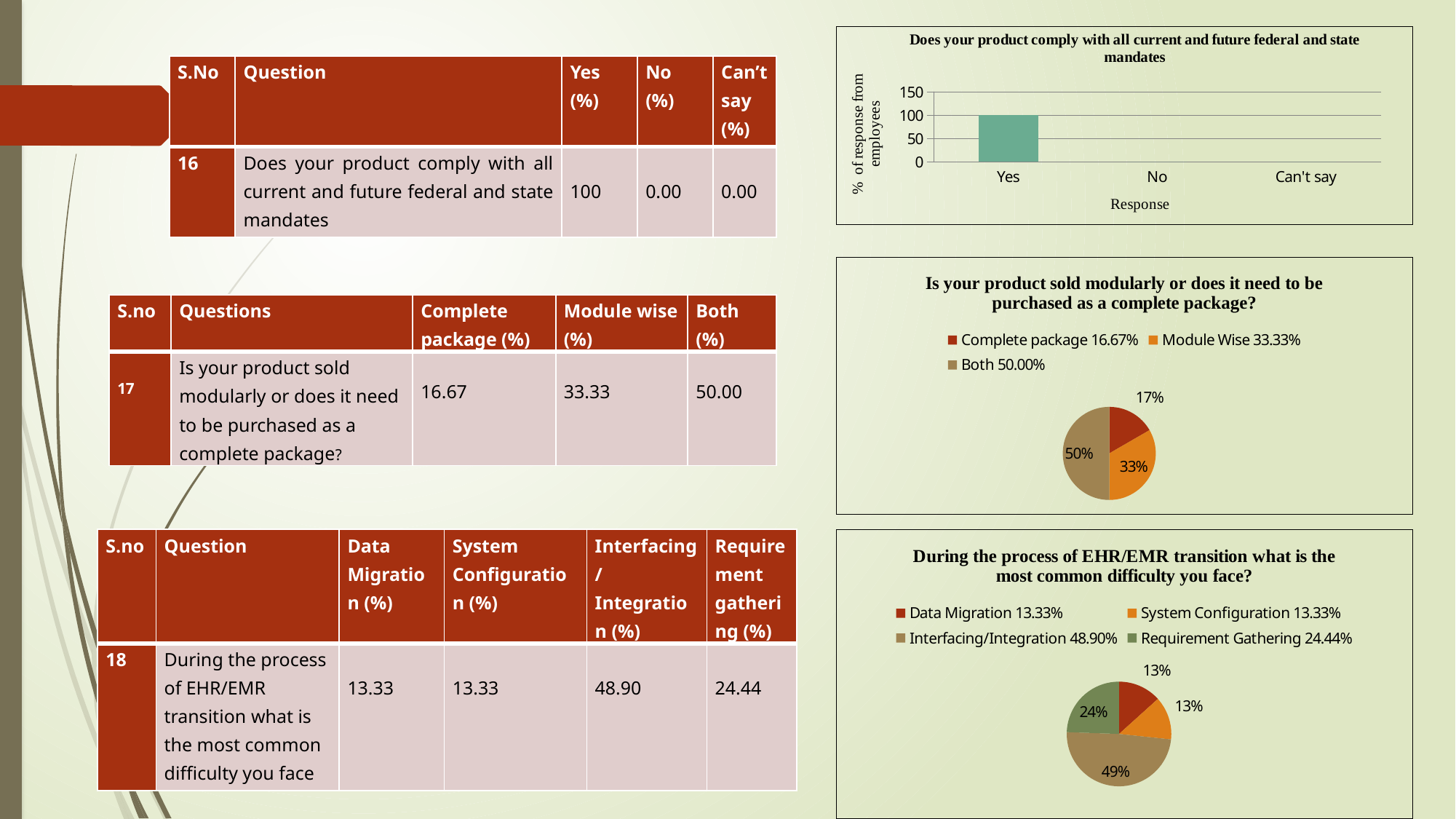
In the top chart titled 'Does your product comply with all current and future federal and state mandates', what kind of chart is shown? bar chart In the top bar chart, what is the value for 'Yes'? 100 In the bottom pie chart, which category has the largest slice? Interfacing/Integration In the top bar chart, which response has the highest value? Yes In the bottom pie chart, which is larger: the slice for 'Requirement Gathering' or the slice for 'Data Migration'? Requirement Gathering In the bottom pie chart titled 'During the process of EHR/EMR transition what is the most common difficulty you face?', what share is labelled for 'Interfacing/Integration'? 49% In the bottom pie chart, what is the difference between the labelled shares for 'Interfacing/Integration' and 'Requirement Gathering'? 25% In the middle pie chart, how many entries does the legend list? 3 In the top bar chart, how many response categories are shown on the x axis? 3 In the middle pie chart, which category has the smallest slice? Complete package In the middle pie chart titled 'Is your product sold modularly or does it need to be purchased as a complete package?', what share is labelled for 'Both'? 50% In the top bar chart, what is the label of the y axis? % of response from employees